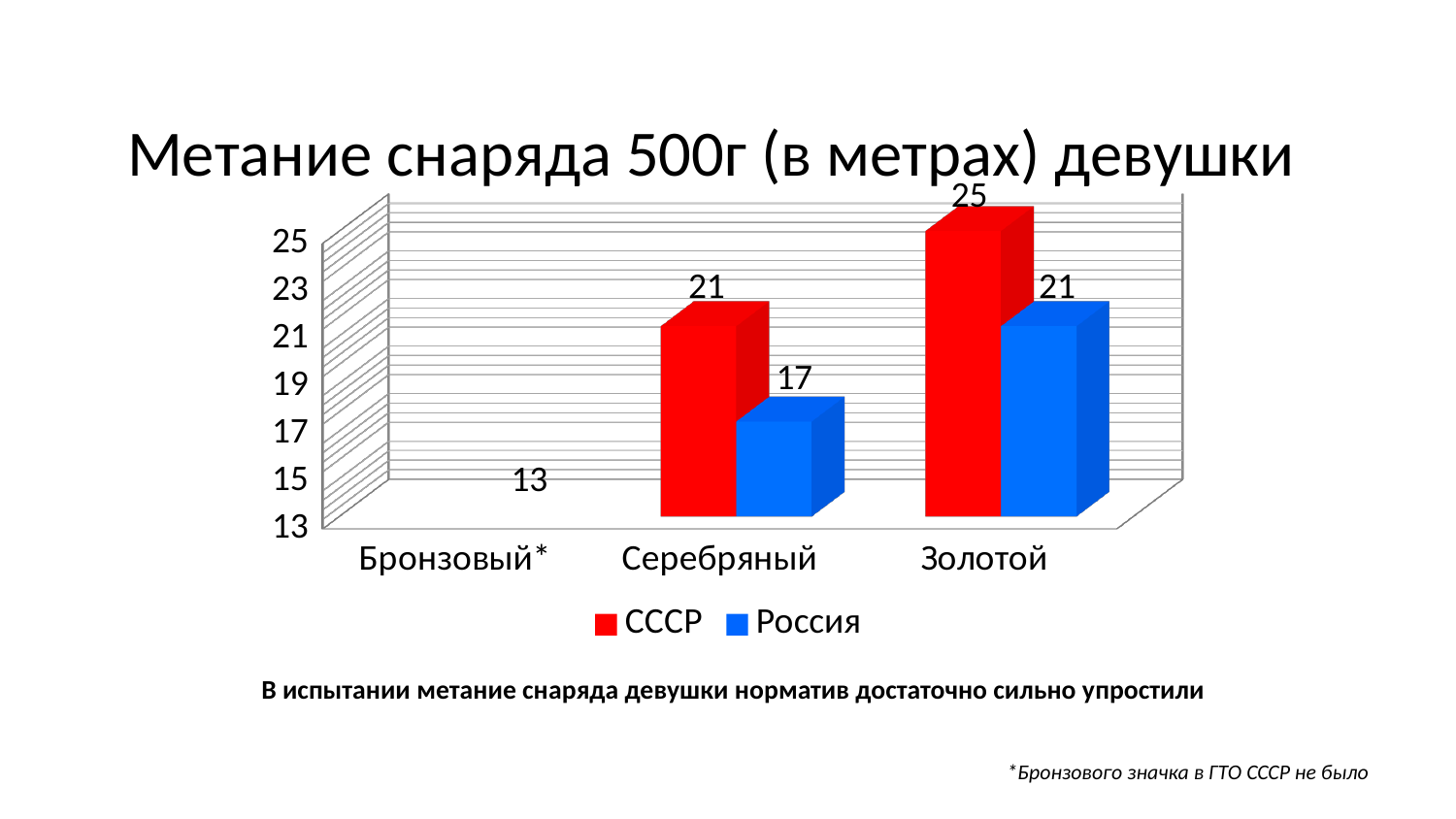
What kind of chart is shown on the slide? Bar chart How many series does the legend list? 2 Which category has the highest value for the СССР series? Золотой What is the difference between the СССР and Россия values in the Серебряный category? 4 What is the difference between the СССР and Россия values in the Золотой category? 4 How many categories are shown on the x axis? 3 What is the value for СССР in the Серебряный category? 21 For the Россия series, which is larger: the Серебряный value or the Золотой value? Золотой What is the value for СССР in the Золотой category? 25 What is the value for Россия in the Золотой category? 21 What colour represents the СССР series? Red What is the value for Россия in the Серебряный category? 17